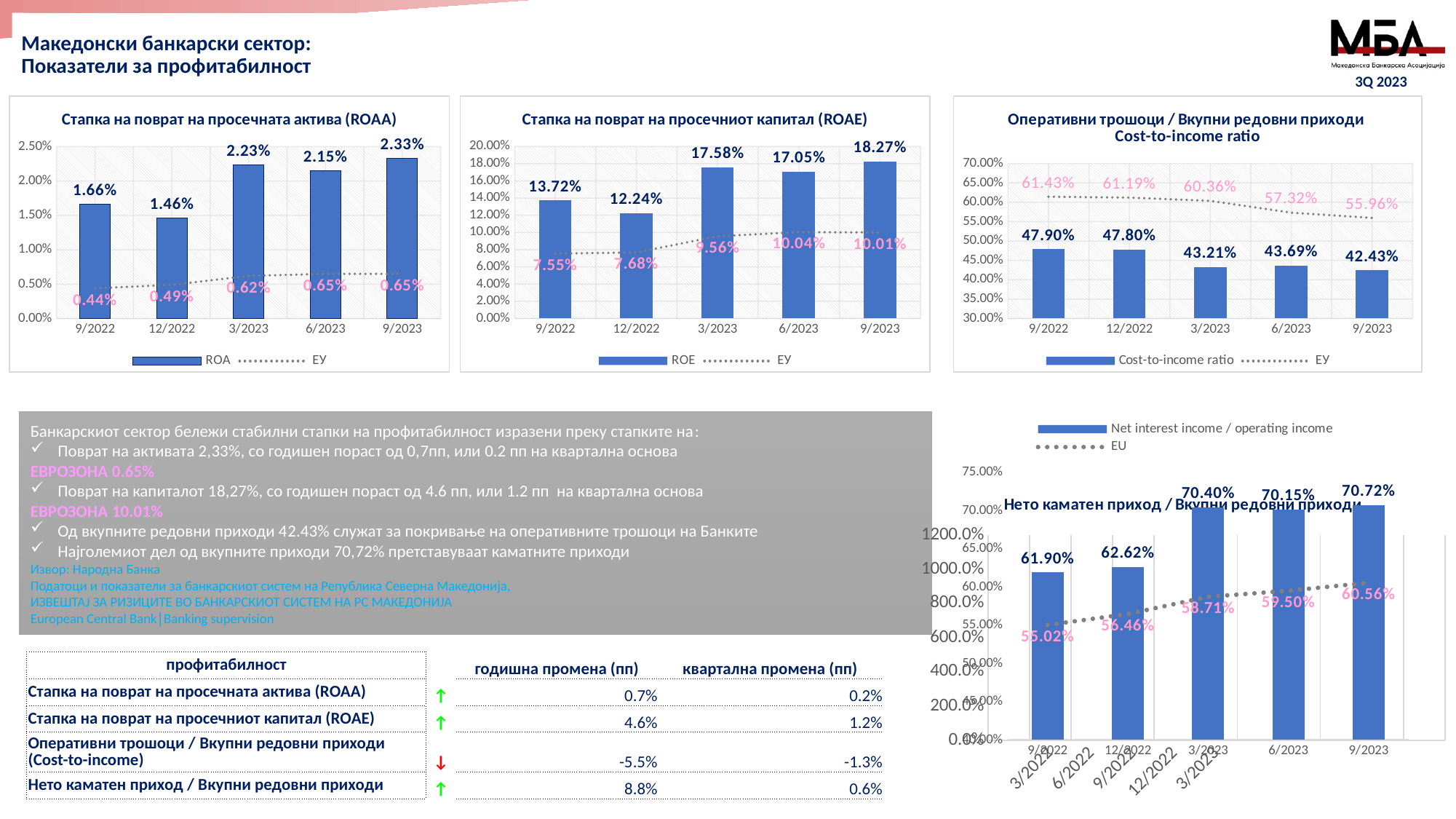
In the ROAE chart (Стапка на поврат на просечниот капитал), what is the ROE value for 3/2023? 17.58% In the Cost-to-income ratio chart, does the EU dotted line rise or fall from 9/2022 to 9/2023? Fall In the ROAA chart (Стапка на поврат на просечната актива), what is the ROA value for 9/2023? 2.33% In the ROAE chart, what is the difference between the ROE value and the EU value for 9/2023? 8.26% How many series does the legend of the ROAA chart list? 2 In the Net interest income / operating income chart (bottom right), what is the Net interest income / operating income value for 12/2022? 62.62% In the ROAE chart, which period has the highest ROE value? 9/2023 In the Net interest income / operating income chart, what is the EU value for 9/2023? 60.56% In the Cost-to-income ratio chart, which is larger for 9/2022: the Cost-to-income ratio or the EU value? EU value In the Cost-to-income ratio chart, what is the Cost-to-income ratio for 9/2023? 42.43% In the ROAA chart, what is the EU (ЕУ) value for 12/2022? 0.49% In the ROAA chart, which period has the lowest ROA value? 12/2022